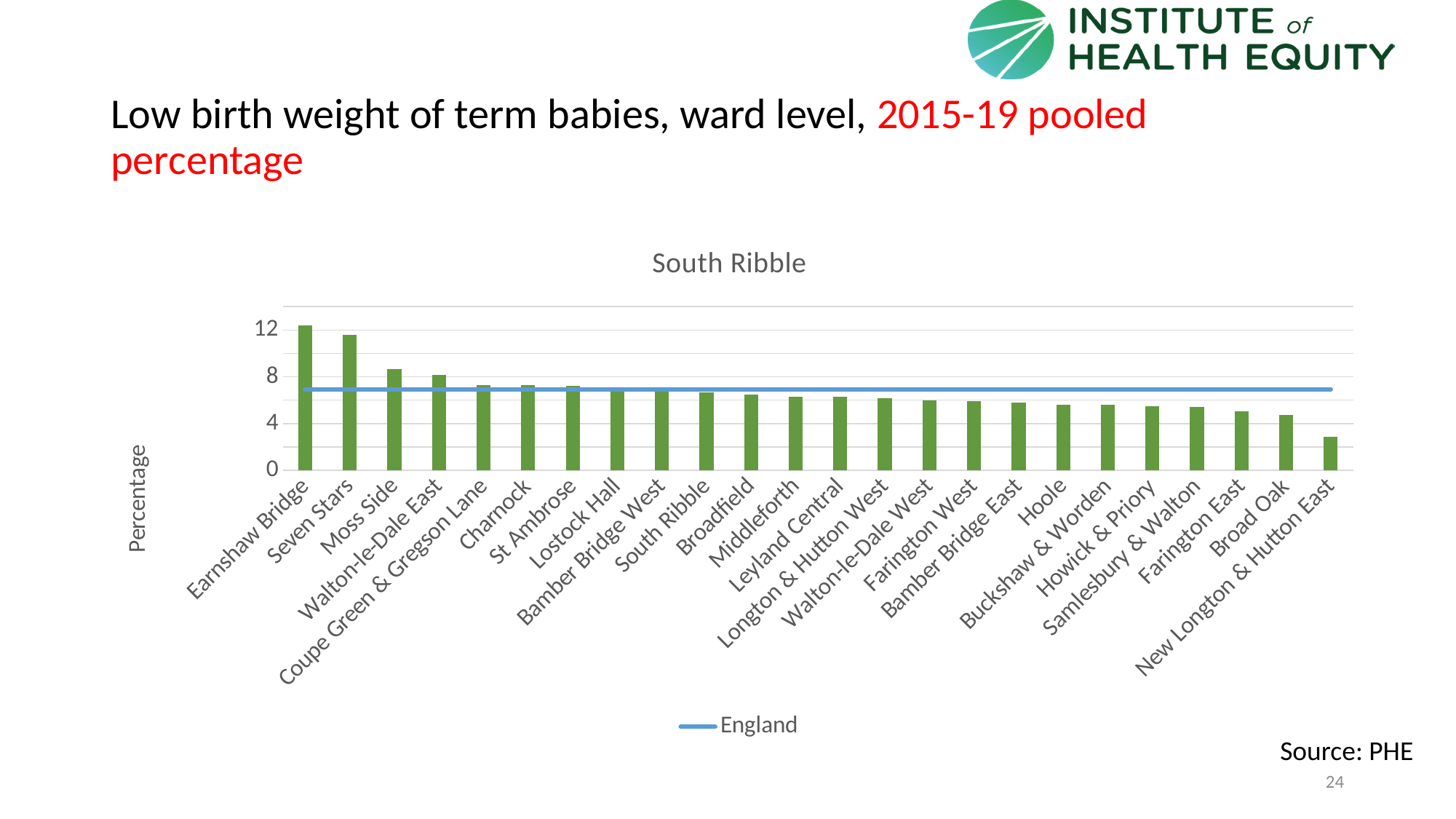
Which is larger, the value for Seven Stars or the value for Moss Side? Seven Stars How many wards are plotted on the chart? 24 What is the title of the chart? South Ribble Is the value for Moss Side greater or less than 12? less Which ward has the highest low birth weight percentage? Earnshaw Bridge Is the value for New Longton & Hutton East greater or less than 4? less Do the bar values rise or fall from left to right along the x axis? Fall Is the value for Hoole greater or less than 4? greater What kind of chart is shown on the slide? Bar chart Which ward has the lowest low birth weight percentage? New Longton & Hutton East Which is larger, the value for Broad Oak or the value for Earnshaw Bridge? Earnshaw Bridge